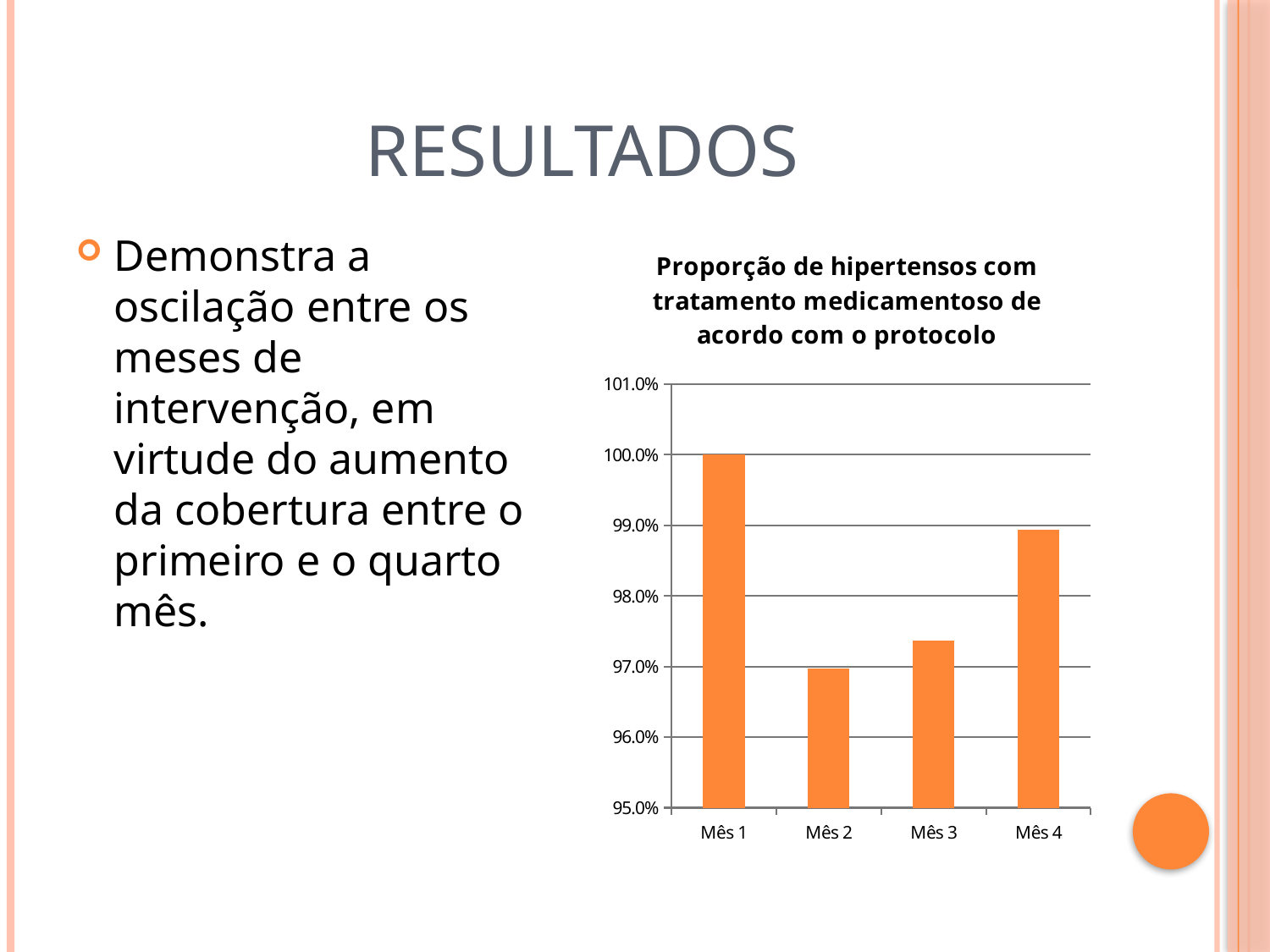
What kind of chart is shown on the slide? bar chart Do the values rise or fall from Mês 2 to Mês 4? rise Which month has the highest proportion in the chart? Mês 1 Is the value for Mês 4 greater or less than 98.0%? greater What is the title of the chart? Proporção de hipertensos com tratamento medicamentoso de acordo com o protocolo What is the value for Mês 1 in the chart? 100.0% Is the value for Mês 2 greater or less than 96.0%? greater Which is larger, the value for Mês 1 or the value for Mês 4? Mês 1 Which is larger, the value for Mês 3 or the value for Mês 4? Mês 4 Is the value for Mês 3 greater or less than 98.0%? less How many months (categories) are shown on the x axis of the chart? 4 Which month has the lowest proportion in the chart? Mês 2